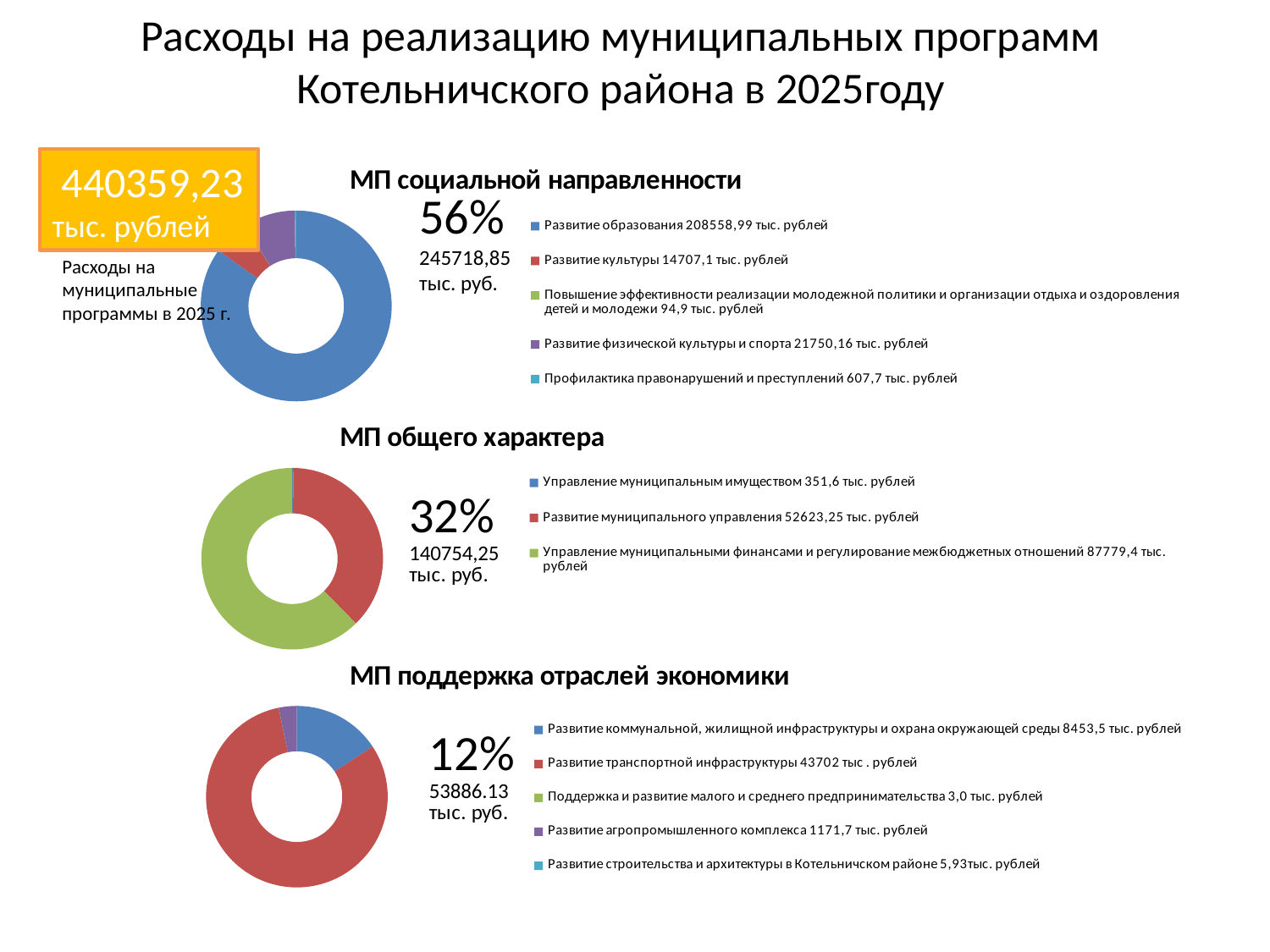
On the chart 'МП поддержка отраслей экономики', what is the value for 'Развитие транспортной инфраструктуры'? 43702 тыс. рублей On the chart 'МП социальной направленности', which category has the largest value? Развитие образования On the chart 'МП социальной направленности', which category has the smallest value? Повышение эффективности реализации молодежной политики и организации отдыха и оздоровления детей и молодежи On the chart 'МП поддержка отраслей экономики', which category has the smallest value? Поддержка и развитие малого и среднего предпринимательства On the chart 'МП социальной направленности', what is the value for 'Развитие образования'? 208558,99 тыс. рублей On the chart 'МП общего характера', what is the difference between 'Управление муниципальными финансами и регулирование межбюджетных отношений' and 'Развитие муниципального управления'? 35156,15 тыс. рублей What kind of chart is used for 'МП общего характера'? doughnut chart On the chart 'МП общего характера', which is larger: 'Управление муниципальным имуществом' or 'Развитие муниципального управления'? Развитие муниципального управления On the chart 'МП общего характера', what is the value for 'Развитие муниципального управления'? 52623,25 тыс. рублей On the chart 'МП социальной направленности', how many categories does the legend list? 5 On the chart 'МП поддержка отраслей экономики', what is the difference between 'Развитие транспортной инфраструктуры' and 'Развитие коммунальной, жилищной инфраструктуры и охрана окружающей среды'? 35248,5 тыс. рублей On the chart 'МП социальной направленности', what share of total programme spending does this group represent, as printed next to the chart? 56%